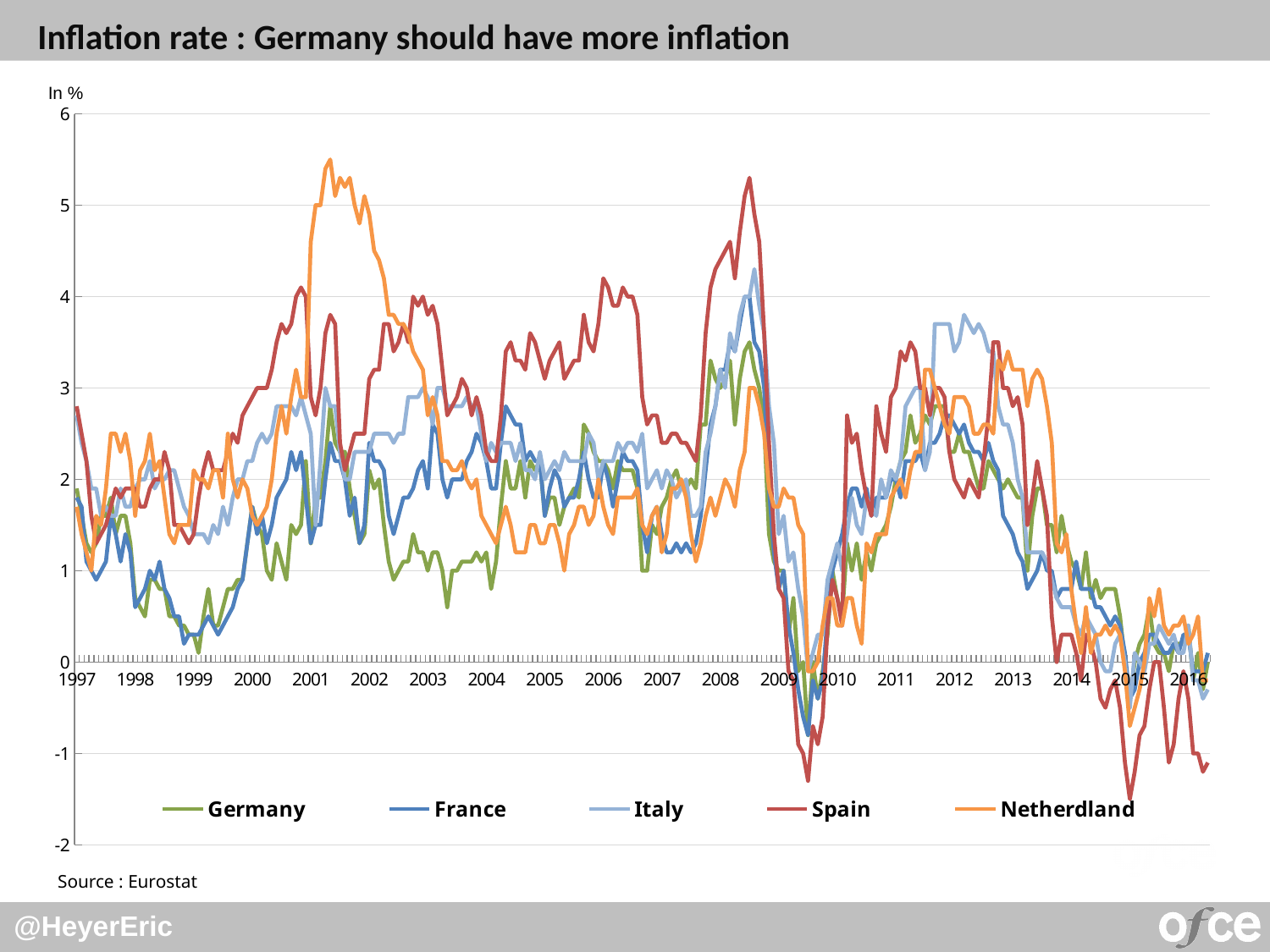
How many series does the legend list? 5 What kind of chart is shown on the slide? line chart Is the lowest value for Spain around 2015 greater or less than -1? less Is the value for Germany in 2003 greater or less than 2? less Which countries are listed in the legend? Germany, France, Italy, Spain, Netherdland Is the peak value for Netherdland around 2001 greater or less than 5? greater Does the Germany series rise or fall between 2012 and 2016? fall Which series reaches the lowest value on the chart? Spain Which series is higher in 2006, Spain or Germany? Spain What is the source cited below the chart? Eurostat